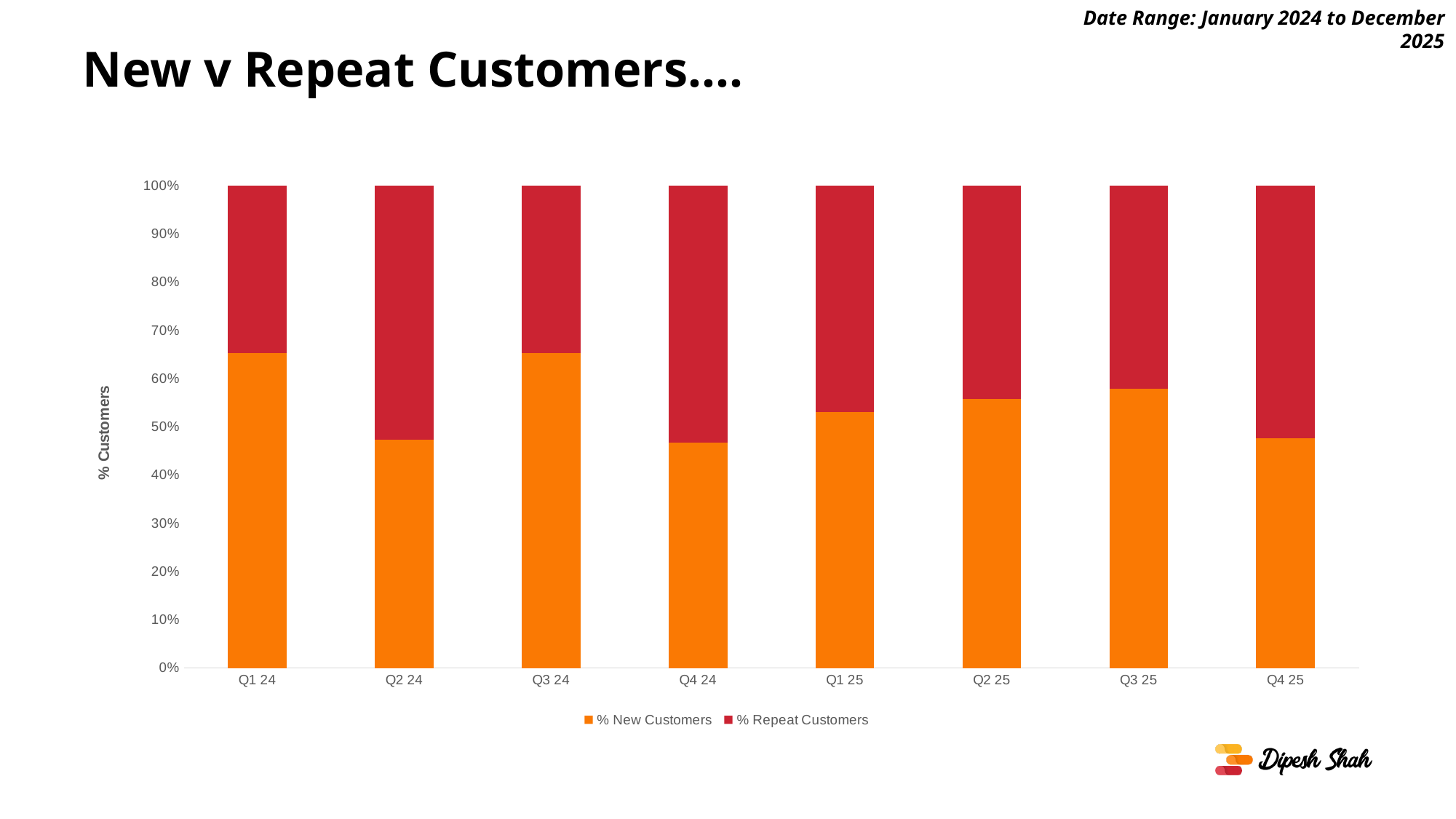
What is the title of the chart slide? New v Repeat Customers.... Which series is shown in orange in the chart legend? % New Customers How many series does the chart legend list? 2 What is the total height of the stacked bar for Q1 24? 100% How many quarters are shown along the x axis of the chart? 8 Is the % New Customers value for Q1 24 greater or less than 60%? greater Which quarter has a larger % Repeat Customers share, Q3 24 or Q4 24? Q4 24 Is the % Repeat Customers value for Q4 25 greater or less than 50%? greater What kind of chart is shown on the slide? Stacked bar chart Is the % New Customers value for Q3 25 greater or less than 60%? less Which quarter has a larger % New Customers share, Q1 24 or Q2 24? Q1 24